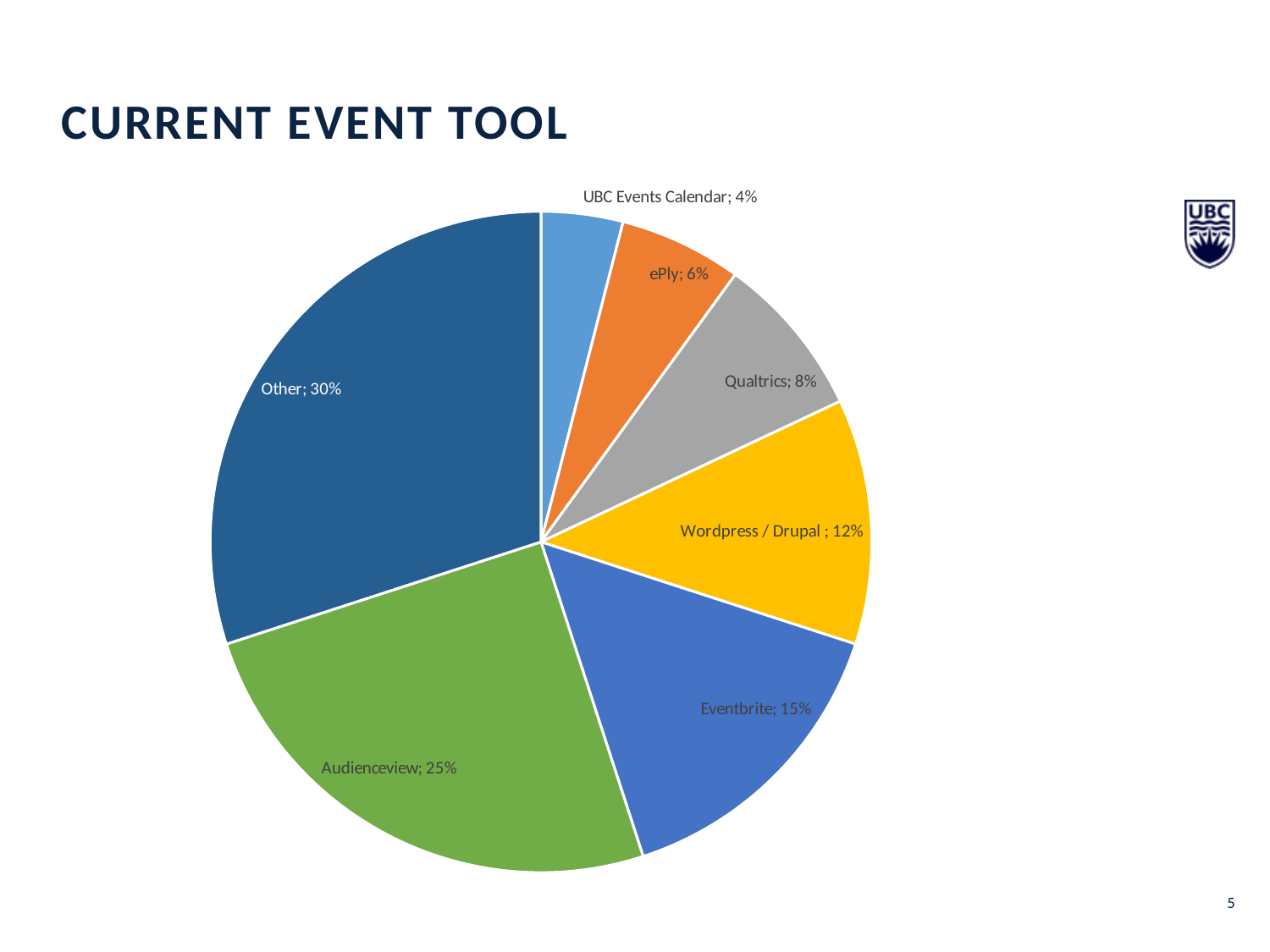
What is the difference between the shares for Other and Audienceview? 5% Which is larger, the share for Wordpress / Drupal or the share for ePly? Wordpress / Drupal What is the value shown for UBC Events Calendar? 4% What is the difference between the shares for Eventbrite and Qualtrics? 7% How many slices does the pie chart have? 7 What is the title of the slide containing the pie chart? CURRENT EVENT TOOL What is the value shown for Qualtrics? 8% What is the value shown for Eventbrite? 15% Which category has the smallest slice of the pie? UBC Events Calendar What kind of chart is shown on the slide? pie chart What share of the pie does Audienceview have? 25% Which category has the largest slice of the pie? Other